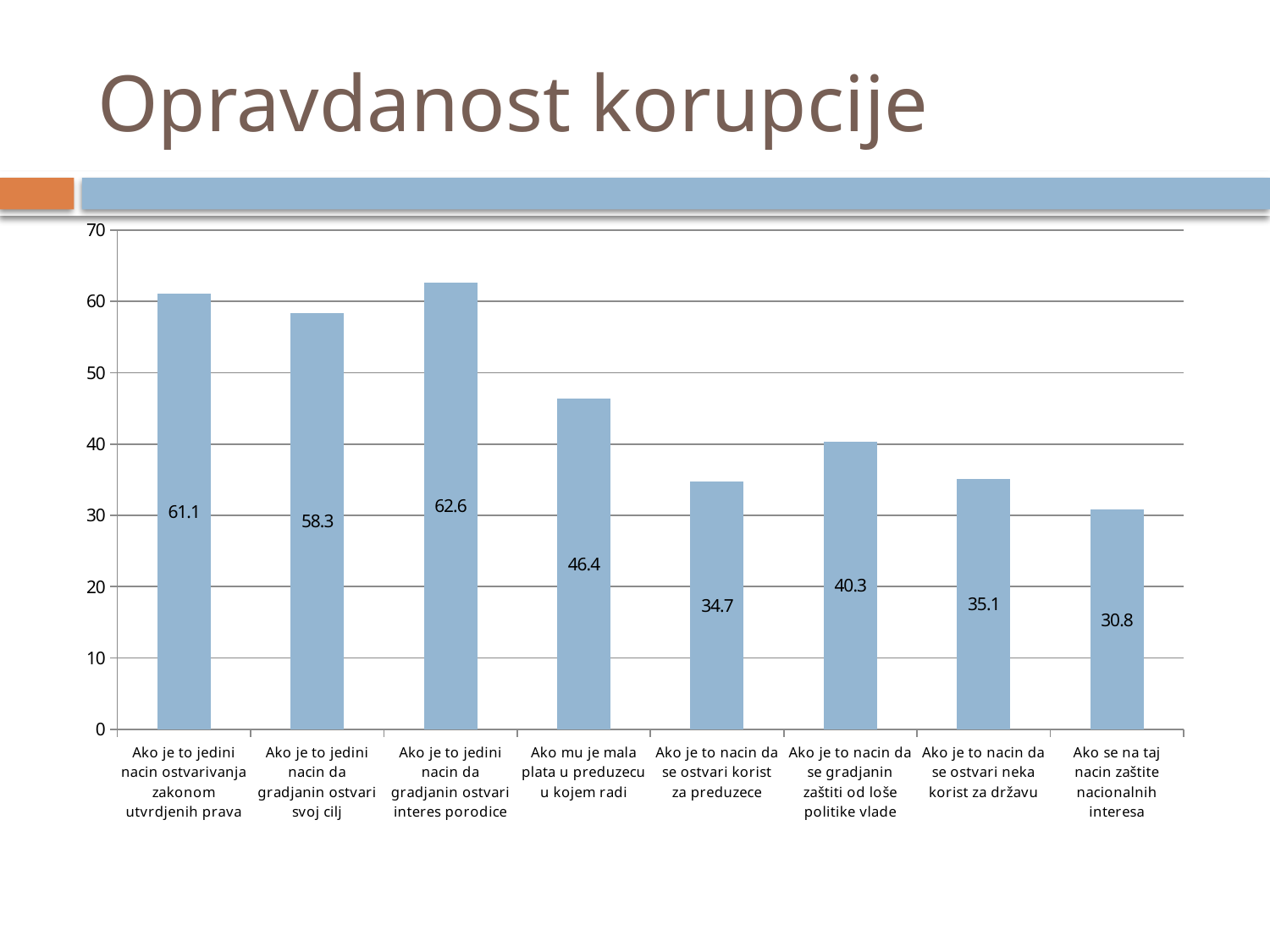
What is the difference between the highest and lowest values in the chart? 31.8 How many categories are shown in the chart? 8 What is the value for 'Ako se na taj nacin zaštite nacionalnih interesa'? 30.8 Which is larger: the value for 'Ako je to nacin da se gradjanin zaštiti od loše politike vlade' or the value for 'Ako je to nacin da se ostvari neka korist za državu'? Ako je to nacin da se gradjanin zaštiti od loše politike vlade What is the difference between the values for 'Ako je to jedini nacin ostvarivanja zakonom utvrdjenih prava' and 'Ako je to jedini nacin da gradjanin ostvari svoj cilj'? 2.8 What is the value for 'Ako mu je mala plata u preduzecu u kojem radi'? 46.4 What is the title of the slide? Opravdanost korupcije What is the value for 'Ako je to jedini nacin da gradjanin ostvari interes porodice'? 62.6 Which category has the highest value? Ako je to jedini nacin da gradjanin ostvari interes porodice Which category has the lowest value? Ako se na taj nacin zaštite nacionalnih interesa What kind of chart is shown on the slide? bar chart Is the value for 'Ako je to nacin da se ostvari korist za preduzece' greater or less than 40? less